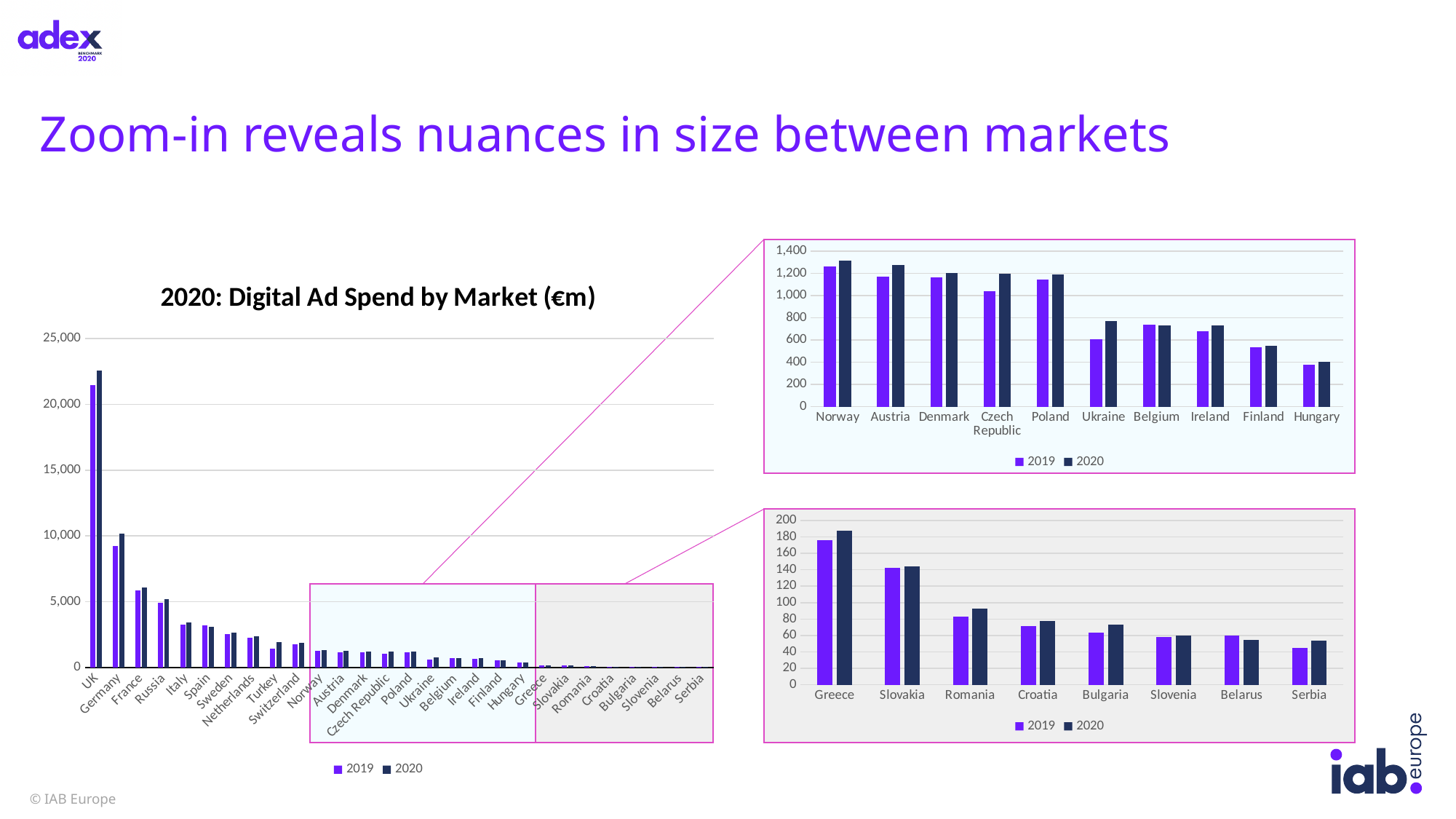
In the top-right zoomed chart (Norway to Hungary), which is larger for the Czech Republic, the 2019 value or the 2020 value? 2020 In the main chart '2020: Digital Ad Spend by Market (€m)', do the values generally rise or fall moving from left to right along the x axis? fall In the main chart '2020: Digital Ad Spend by Market (€m)', how many markets are shown on the x axis? 28 What type of chart is the main chart titled '2020: Digital Ad Spend by Market (€m)'? bar chart In the main chart '2020: Digital Ad Spend by Market (€m)', which market has the highest value? UK In the main chart '2020: Digital Ad Spend by Market (€m)', how many series does the legend list? 2 In the bottom-right zoomed chart (Greece to Serbia), how many markets are shown? 8 In the main chart '2020: Digital Ad Spend by Market (€m)', is the 2020 value for the UK greater or less than 20,000? greater In the top-right zoomed chart (Norway to Hungary), which market has the highest 2020 value? Norway In the top-right zoomed chart (Norway to Hungary), is the 2019 value for Hungary greater or less than 400? less In the top-right zoomed chart (Norway to Hungary), is the 2020 value for Ukraine greater or less than 600? greater